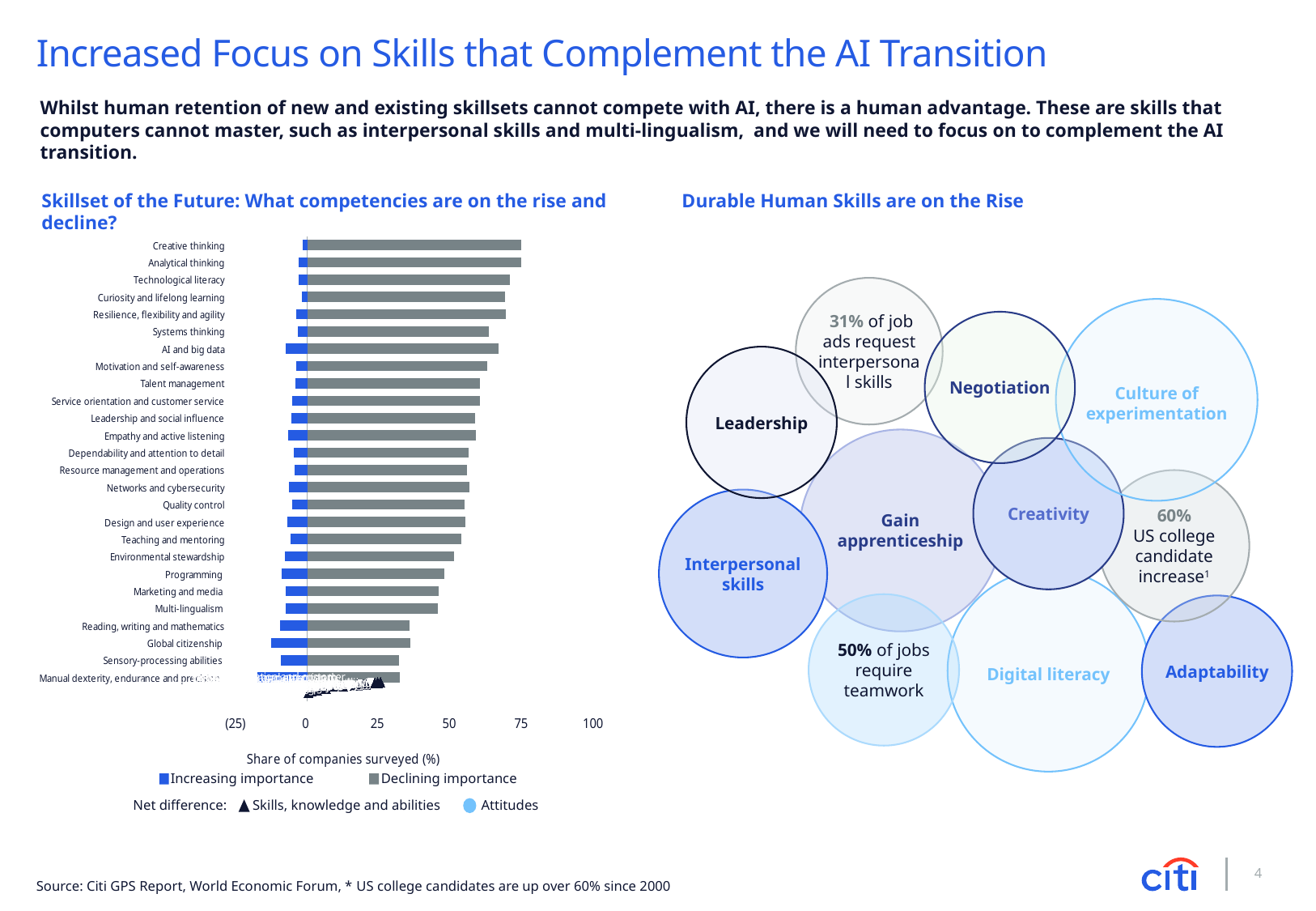
How many competencies are listed on the 'Skillset of the Future' chart? 26 On the 'Skillset of the Future' chart, which competency is listed last at the bottom? Manual dexterity, endurance and precision On the 'Skillset of the Future' chart, which has the longer gray bar: Systems thinking or Programming? Systems thinking On the 'Skillset of the Future' chart, is the gray bar for Global citizenship greater or less than 50? less What is the x-axis label on the 'Skillset of the Future' chart? Share of companies surveyed (%) On the 'Skillset of the Future' chart, is the gray bar for Systems thinking greater or less than 50? greater On the 'Skillset of the Future' chart, which has the longer gray bar: Creative thinking or Manual dexterity, endurance and precision? Creative thinking On the 'Skillset of the Future' chart, is the gray bar for Reading, writing and mathematics greater or less than 50? less What kind of chart is 'Skillset of the Future: What competencies are on the rise and decline?' bar chart On the 'Skillset of the Future' chart, which competency is listed first at the top? Creative thinking